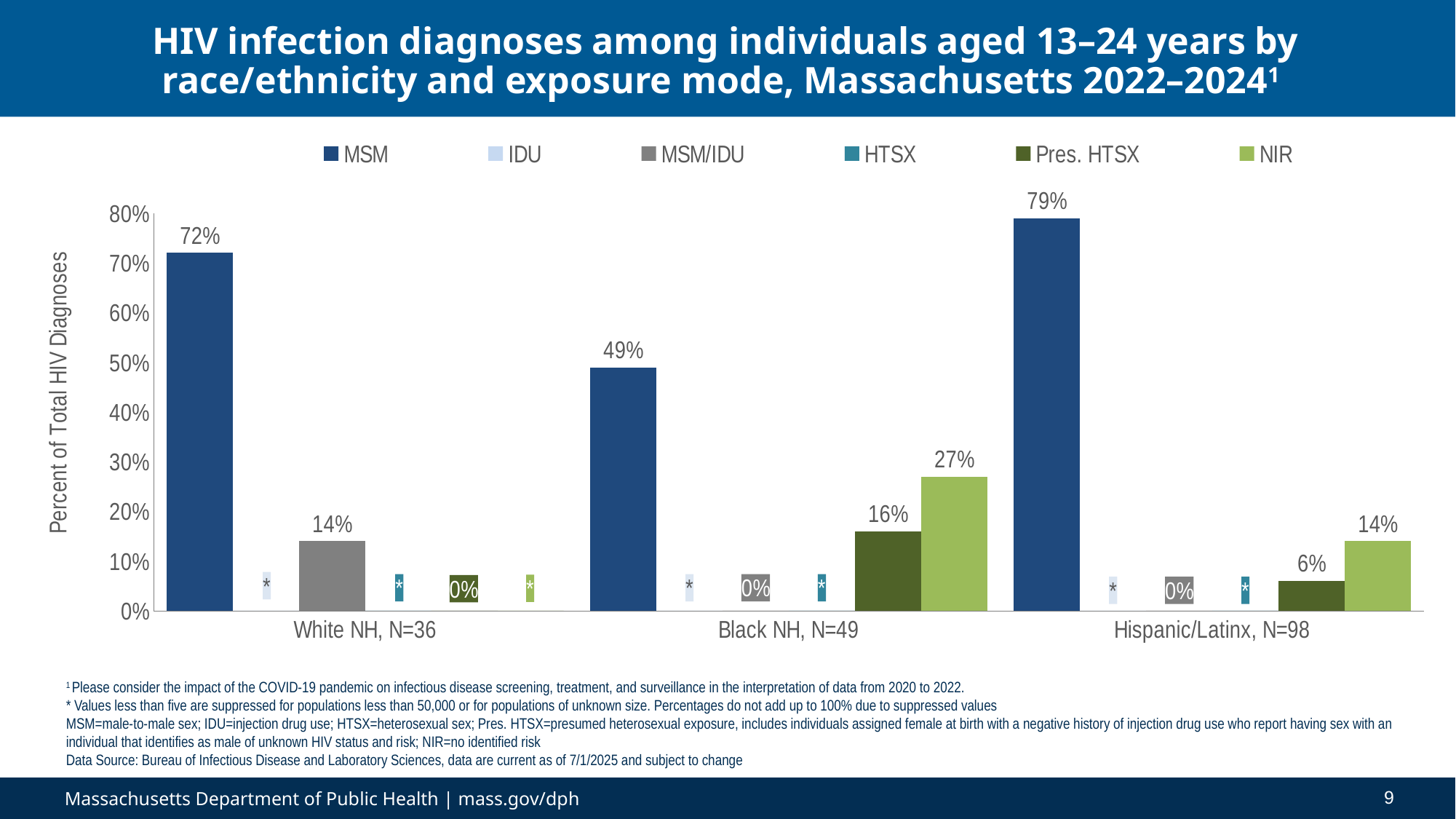
Which is larger: the NIR value for Black NH or the NIR value for Hispanic/Latinx? Black NH What percentage of HIV diagnoses among White NH individuals aged 13–24 were attributed to MSM? 72% Is the MSM value for Black NH greater or less than 50%? less How many exposure mode series does the legend list? 6 What type of chart is shown on the slide? Bar chart What is the Pres. HTSX value for the Hispanic/Latinx group? 6% What is the difference between the MSM percentage for Hispanic/Latinx and for Black NH? 30% What percentage of HIV diagnoses among Black NH individuals aged 13–24 were attributed to NIR? 27% Which race/ethnicity group has the highest MSM percentage? Hispanic/Latinx Which race/ethnicity group has the lowest MSM percentage? Black NH How many race/ethnicity groups are shown on the x axis? 3 What is the MSM/IDU value for the White NH group? 14%